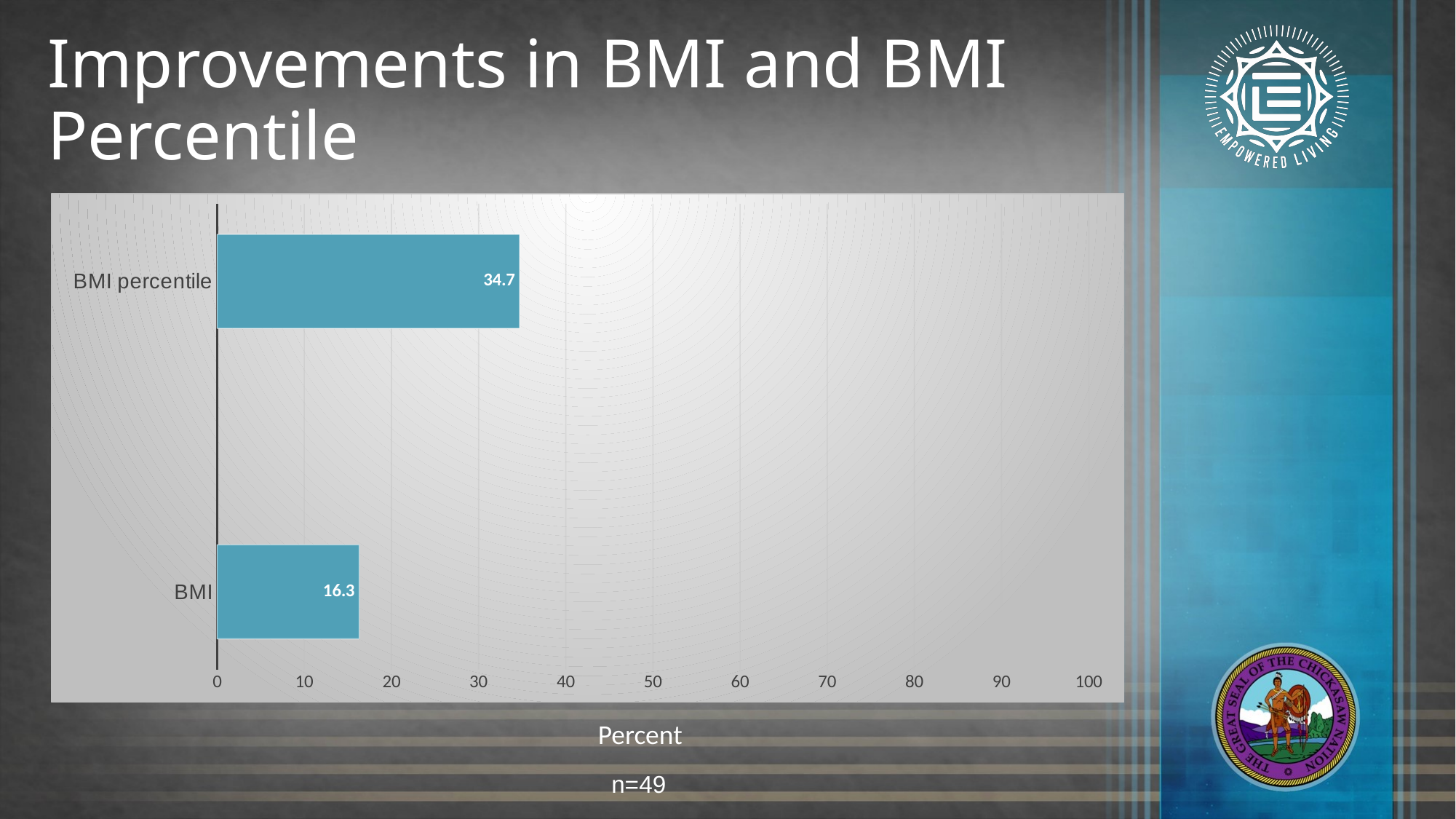
Which is larger, the value for BMI percentile or the value for BMI? BMI percentile How many categories are shown in the chart? 2 Which category has the lowest value? BMI Which category has the highest value? BMI percentile What is the value for BMI percentile? 34.7 Is the value for BMI percentile greater or less than 30? greater What is the difference between the BMI percentile value and the BMI value? 18.4 What is the maximum value shown on the horizontal axis? 100 What kind of chart is shown on the slide? bar chart What is the label of the horizontal axis? Percent What is the value for BMI? 16.3 Is the value for BMI greater or less than 20? less